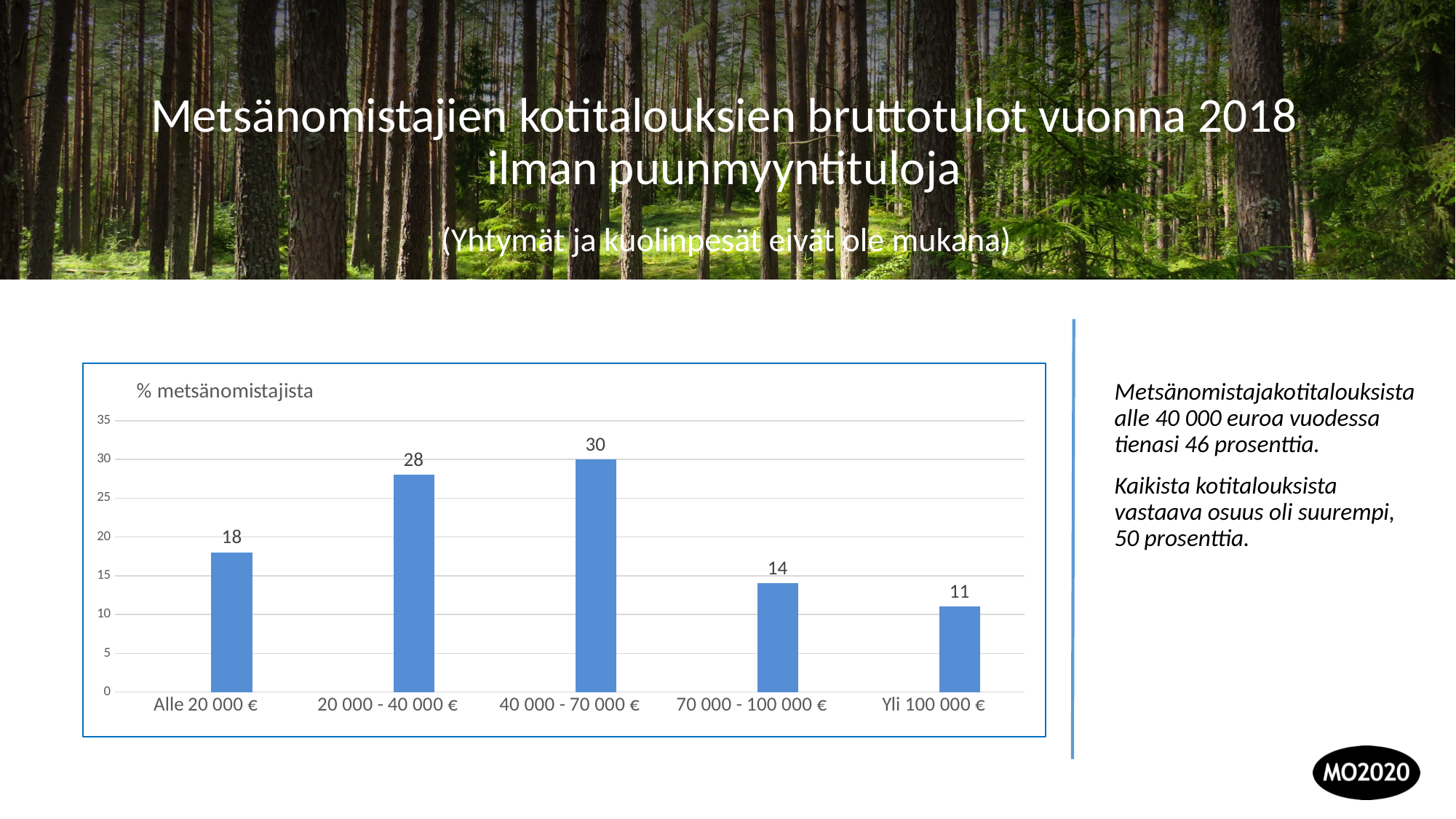
What is the value for the "Yli 100 000 €" category? 11 How many categories are shown on the x axis? 5 What is the label shown above the chart's y axis? % metsänomistajista Is the value for "20 000 - 40 000 €" greater or less than 25? greater What is the value for the "40 000 - 70 000 €" category? 30 Which category has the highest value? 40 000 - 70 000 € What is the difference between the values for "20 000 - 40 000 €" and "70 000 - 100 000 €"? 14 What is the value for the "Alle 20 000 €" category? 18 Which category has the lowest value? Yli 100 000 € What kind of chart is shown on the slide? bar chart What is the total of the values for "Alle 20 000 €" and "20 000 - 40 000 €"? 46 Which is larger, the value for "Alle 20 000 €" or the value for "70 000 - 100 000 €"? Alle 20 000 €